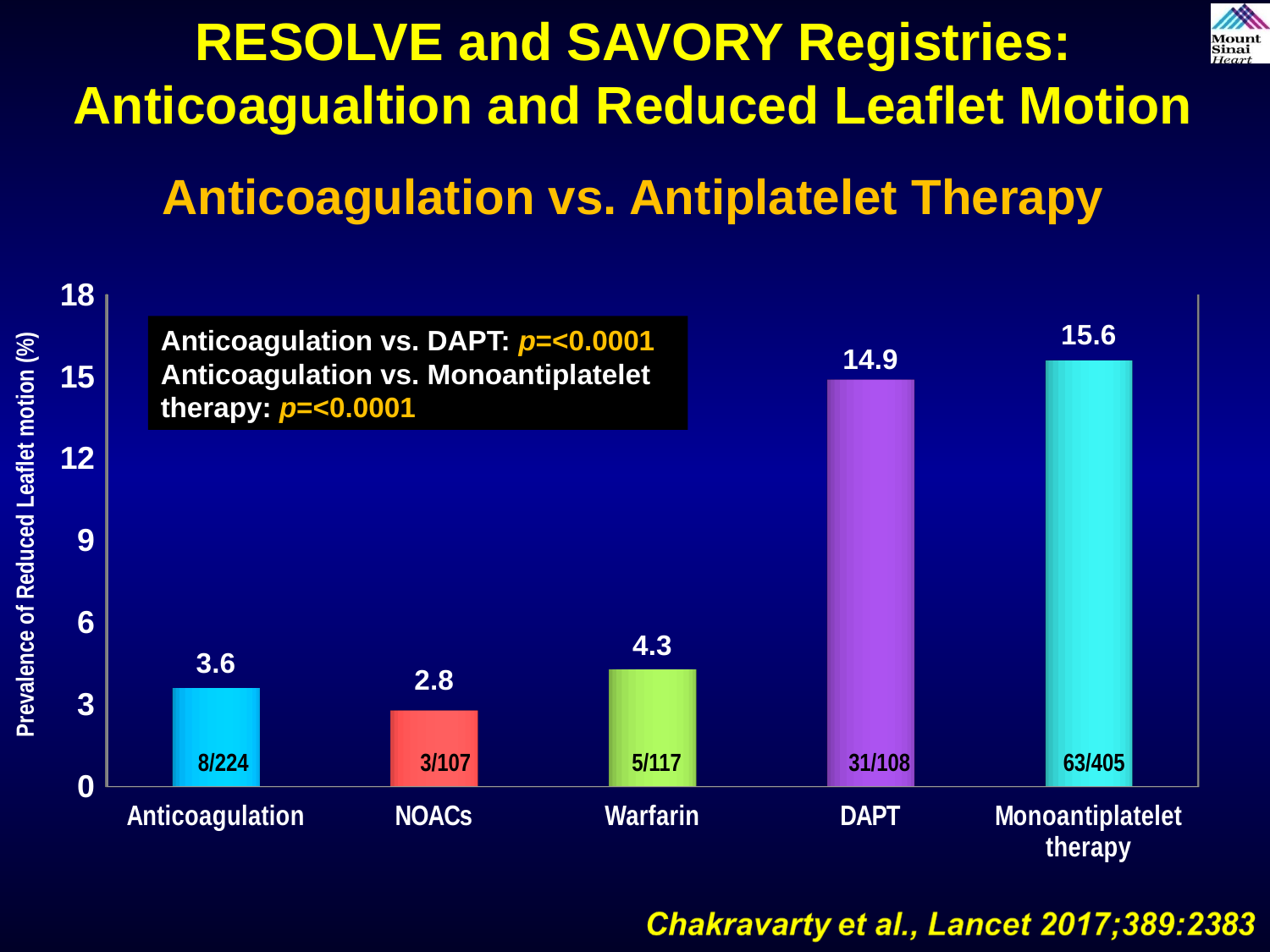
Which category has the highest prevalence of reduced leaflet motion? Monoantiplatelet therapy What is the difference between the values for Monoantiplatelet therapy and DAPT? 0.7 What fraction is printed inside the DAPT bar? 31/108 What is the difference between the values for Warfarin and NOACs? 1.5 Is the value for DAPT greater or less than 12? greater How many categories are shown on the x axis? 5 What is the prevalence of reduced leaflet motion for the Anticoagulation group? 3.6 Which category has the lowest prevalence of reduced leaflet motion? NOACs What kind of chart is shown on the slide? Bar chart What is the prevalence of reduced leaflet motion for DAPT? 14.9 What is the value shown for Warfarin? 4.3 Which is larger, the value for Warfarin or the value for Anticoagulation? Warfarin